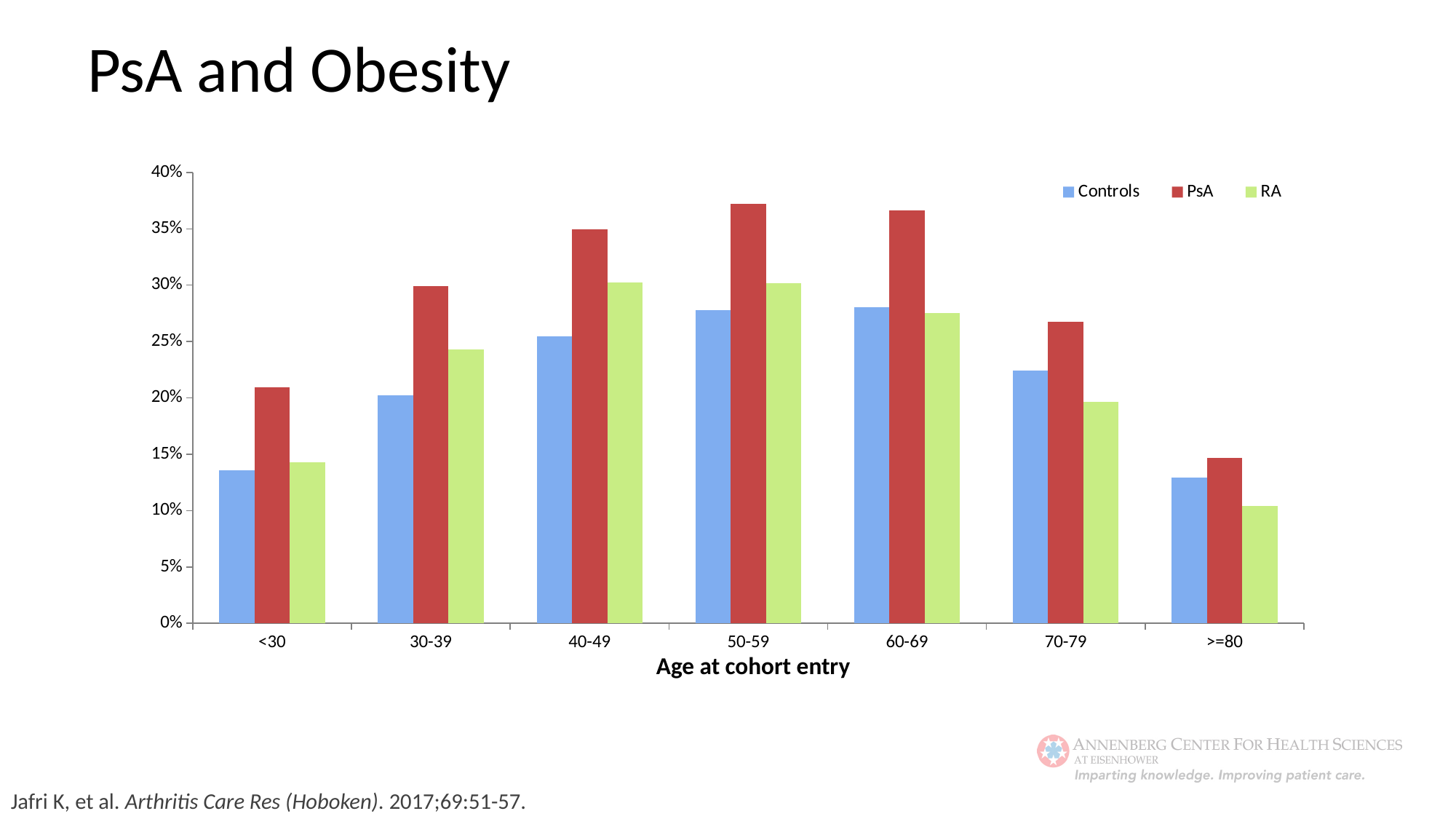
What kind of chart is shown on the slide? Bar chart Is the RA value for the >=80 age group greater or less than 15%? less In the 30-39 age group, which is larger, the RA value or the Controls value? RA Which age group has the lowest PsA value? >=80 In the 50-59 age group, which is larger, the PsA value or the Controls value? PsA Is the Controls value for the <30 age group greater or less than 15%? less How many series does the legend list? 3 Is the PsA value for the 40-49 age group greater or less than 30%? greater What is the title of the x axis? Age at cohort entry How many age categories are shown on the x axis? 7 Which age group has the lowest RA value? >=80